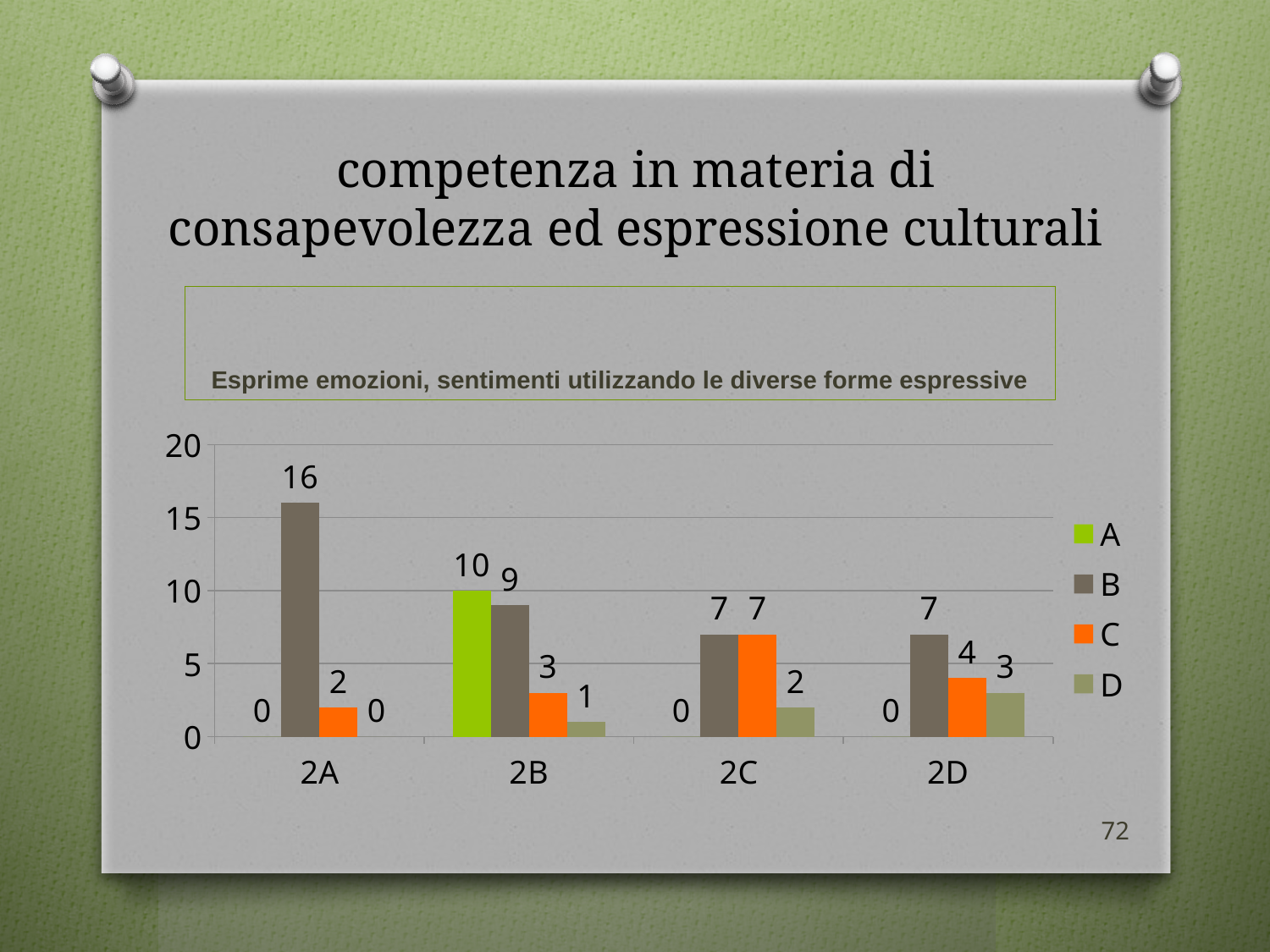
What is the value of series D for category 2C? 2 What is the value of series A for category 2B? 10 Which category has the lowest value for series D? 2A Which is larger for category 2D: series C or series D? series C What kind of chart is shown on the slide? bar chart What is the value of series B for category 2A? 16 What is the value of series C for category 2D? 4 How many categories are shown on the x axis? 4 What is the title shown above the chart? Esprime emozioni, sentimenti utilizzando le diverse forme espressive Which category has the highest value for series B? 2A How many series does the legend list? 4 What is the difference between the series B value for 2A and the series B value for 2B? 7